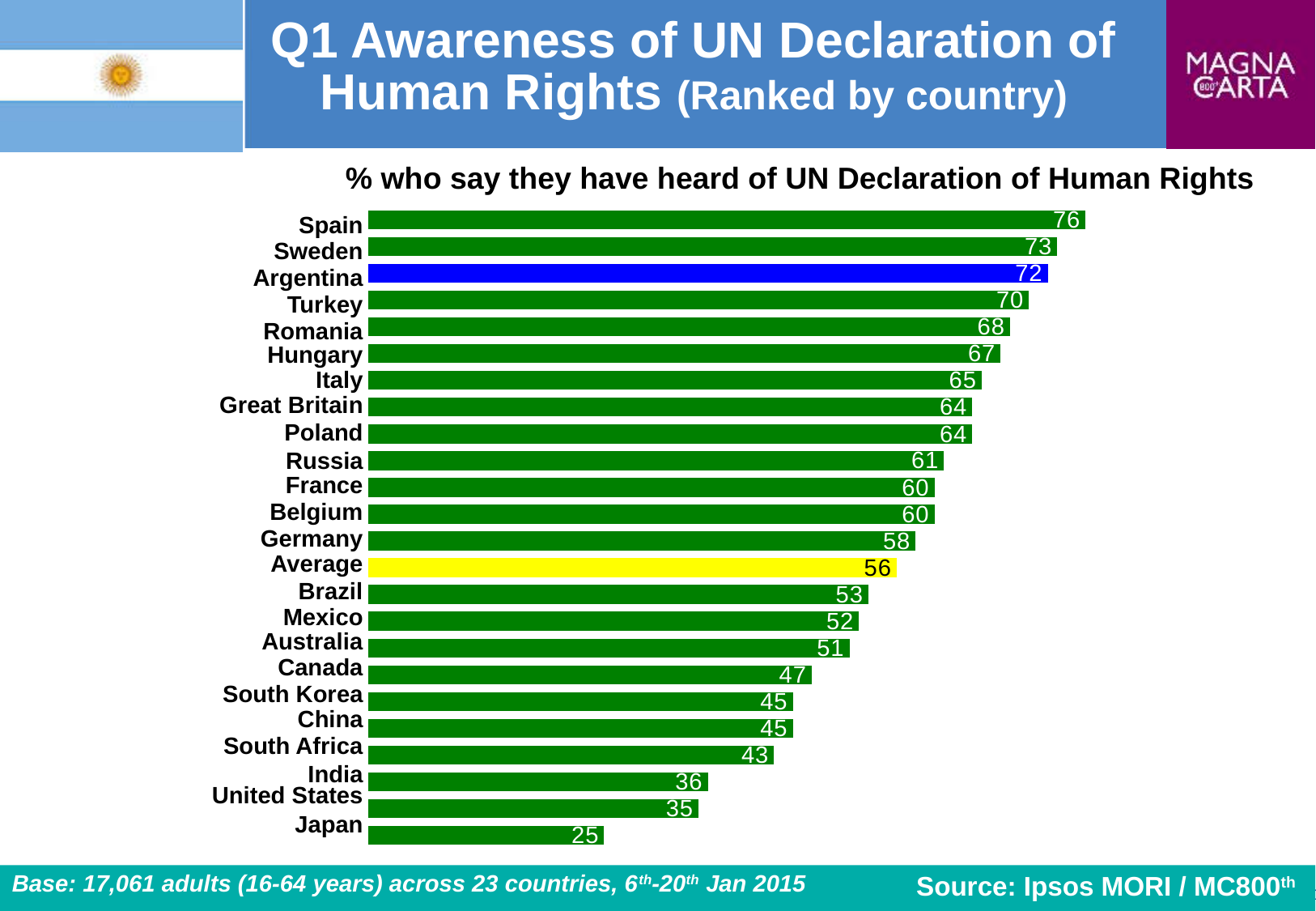
How many bars are shown in the chart? 24 Which country has the highest value? Spain Which bar is coloured blue? Argentina What kind of chart is shown on the slide? Bar chart Which has a larger value, India or United States? India What is the value for Japan? 25 What is the difference between the values for Argentina and the Average? 16 Which country has the lowest value? Japan Which has a larger value, Canada or Brazil? Brazil What is the value shown for Average? 56 What is the value for Argentina? 72 What is the difference between the values for Spain and Japan? 51